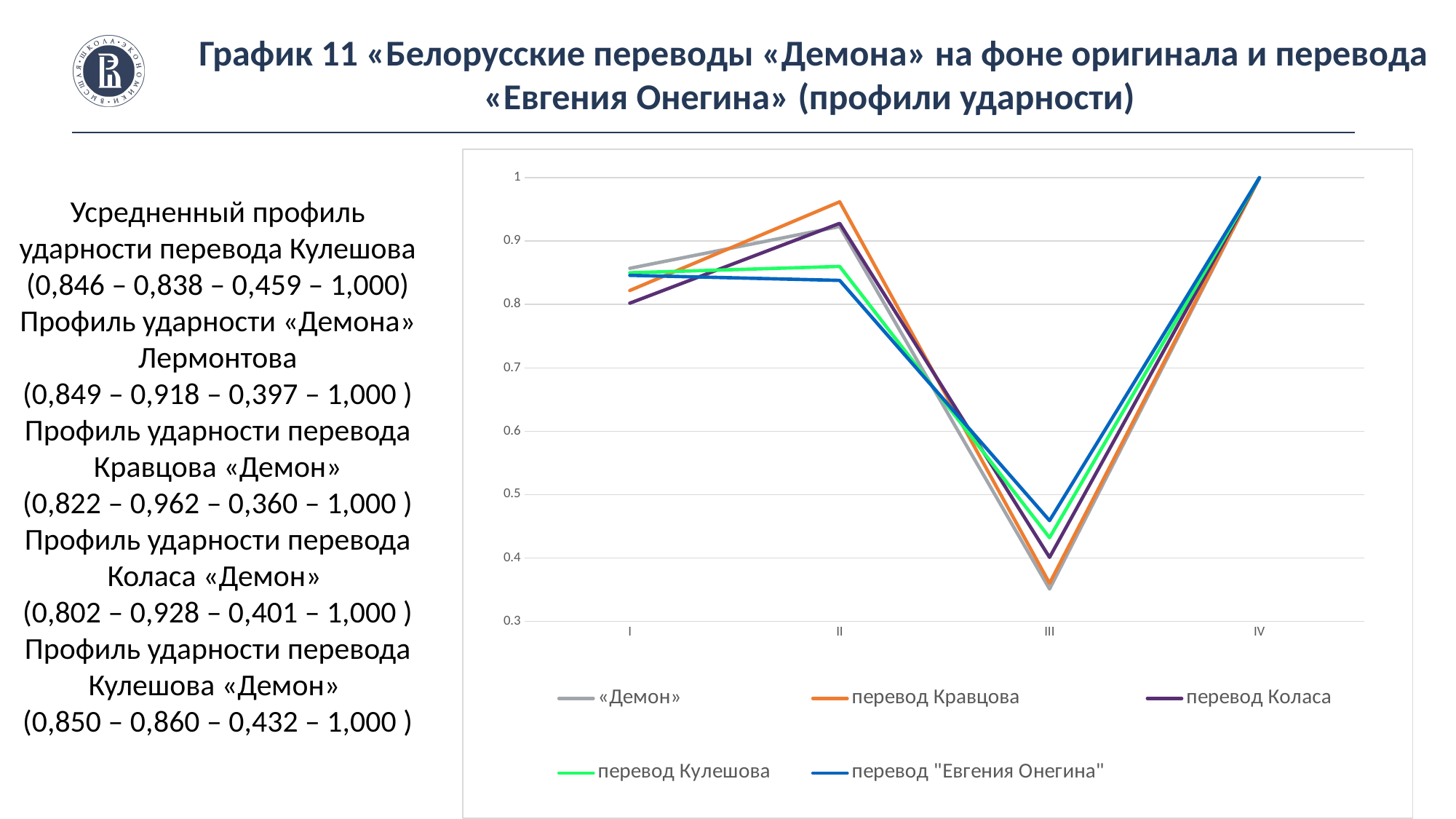
What type of chart is shown on the slide? line chart Do the values of all series rise or fall from point II to point III? fall How many series does the chart legend list? 5 How many points are there along the x axis of the chart? 4 What is the difference between the values of перевод Кравцова at point II and point I? 0,140 What is the value of перевод Кравцова at point II? 0,962 What is the value of перевод Коласа at point III? 0,401 What is the value of перевод Кулешова at point I? 0,850 At point I, which is larger: «Демон» or перевод Коласа? «Демон» What colour is the line for перевод Кравцова in the chart? orange Which series has the highest value at point II? перевод Кравцова Is the value for перевод "Евгения Онегина" at point III greater or less than 0.5? less